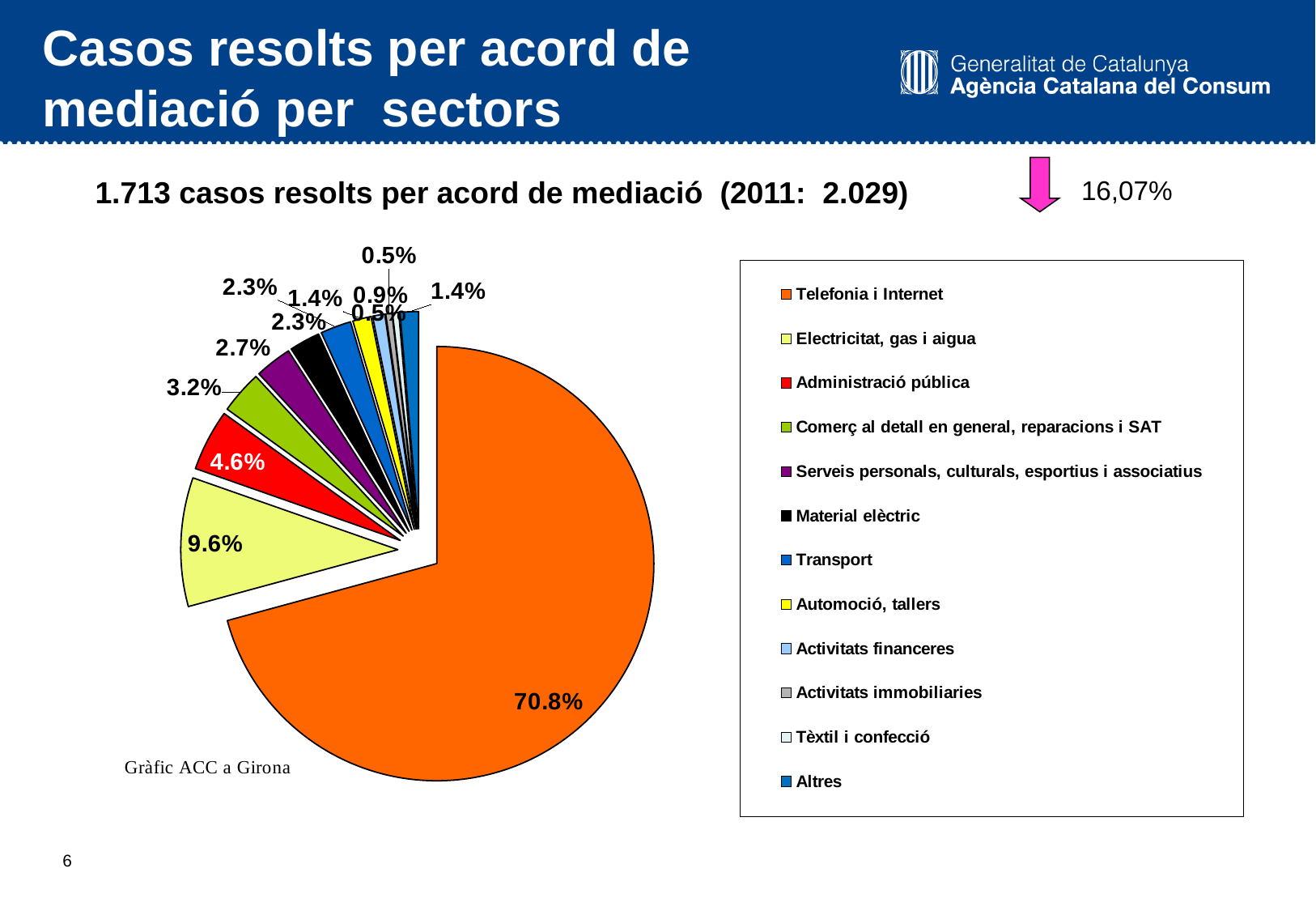
Which has a larger share, Electricitat, gas i aigua or Administració pública? Electricitat, gas i aigua What share of the pie does Electricitat, gas i aigua represent? 9.6% What kind of chart is shown on the slide? Pie chart What share of the pie does Telefonia i Internet represent? 70.8% What is the smallest percentage shown on the pie chart? 0.5% Which sector has the largest slice of the pie? Telefonia i Internet What colour is the slice for Telefonia i Internet? Orange What share of the pie does Administració pública represent? 4.6% How many sectors does the legend list? 12 What share of the pie does Serveis personals, culturals, esportius i associatius represent? 2.7% What is the difference in percentage points between Telefonia i Internet and Electricitat, gas i aigua? 61.2 percentage points What share of the pie does Comerç al detall en general, reparacions i SAT represent? 3.2%